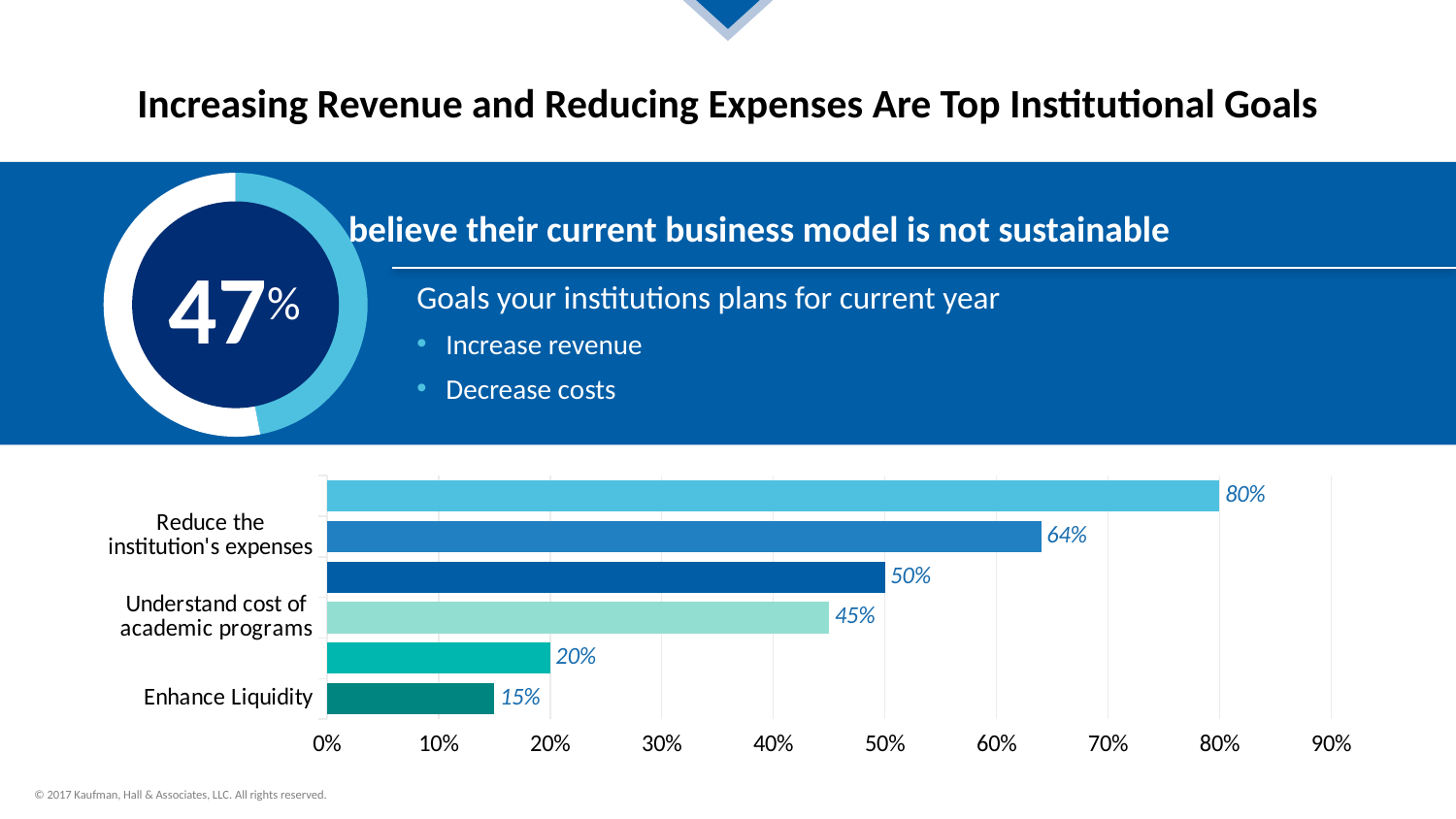
In the bar chart, which labeled category has the lowest value? Enhance Liquidity In the bar chart, is the value for 'Understand cost of academic programs' greater or less than 40%? greater In the bar chart, how many bars are plotted? 6 What type of chart is shown at the bottom of the slide? bar chart In the bar chart, what is the difference between the values for 'Reduce the institution's expenses' and 'Enhance Liquidity'? 49 percentage points In the bar chart, what is the value for 'Reduce the institution's expenses'? 64% In the bar chart, which is larger: 'Reduce the institution's expenses' or 'Understand cost of academic programs'? Reduce the institution's expenses In the bar chart, what is the value for 'Enhance Liquidity'? 15% In the bar chart, what is the value for 'Understand cost of academic programs'? 45% In the bar chart, what is the highest value shown on any bar? 80% What is the maximum value shown on the x axis of the bar chart? 90% What percentage is shown in the donut chart on the left of the slide? 47%